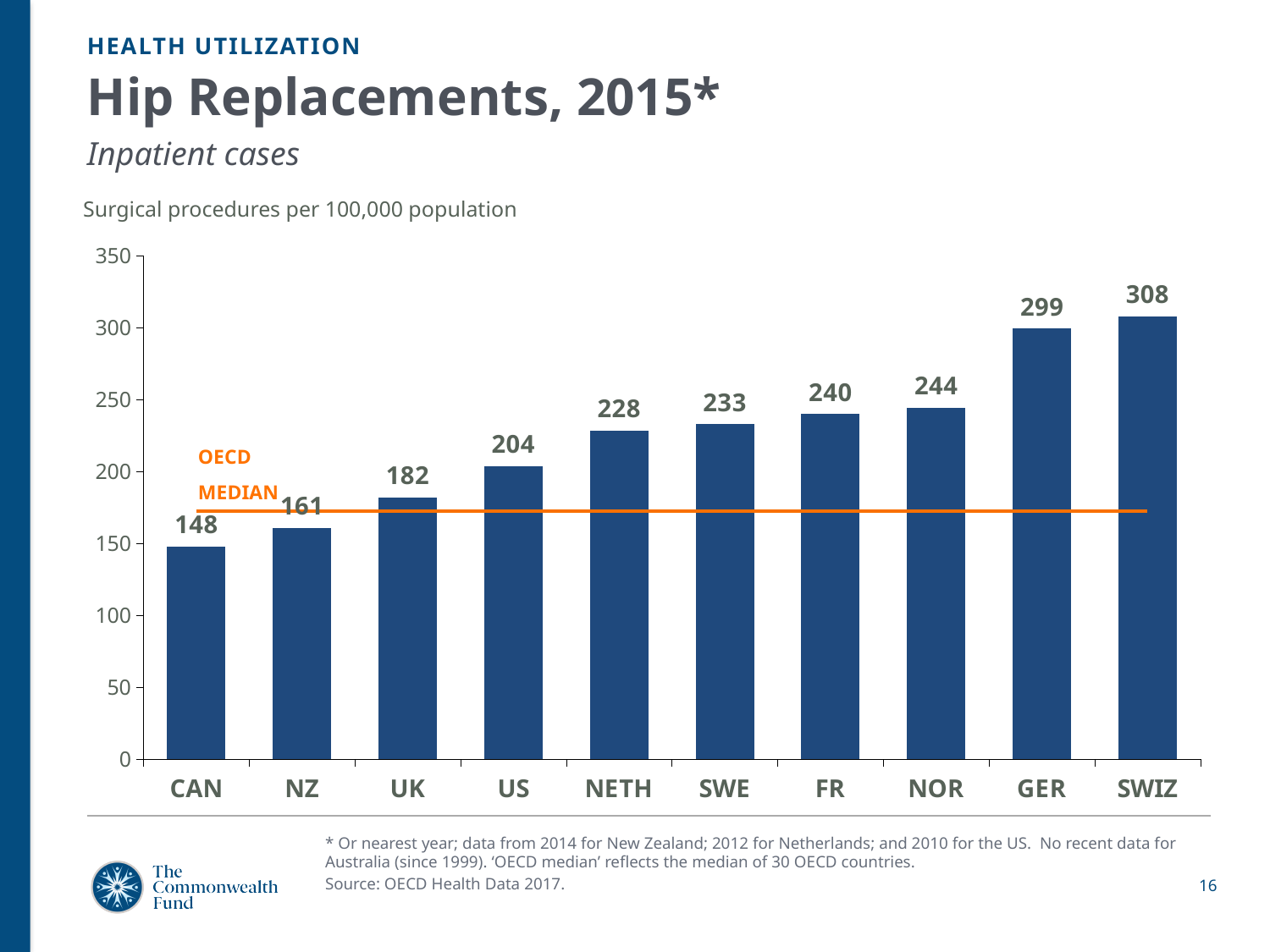
What does the orange horizontal line on the chart represent? OECD median What is the difference between the values for SWIZ and CAN? 160 Which country has the highest number of hip replacements per 100,000 population? SWIZ How many countries are shown on the chart? 10 Which is larger, the value for FR or the value for NETH? FR What is the value for CAN? 148 What is the value for the US? 204 What is the difference between the values for NOR and UK? 62 What kind of chart is shown on the slide? bar chart What is the value for GER? 299 Is the value for NZ greater or less than 200? less Which country has the lowest number of hip replacements per 100,000 population? CAN